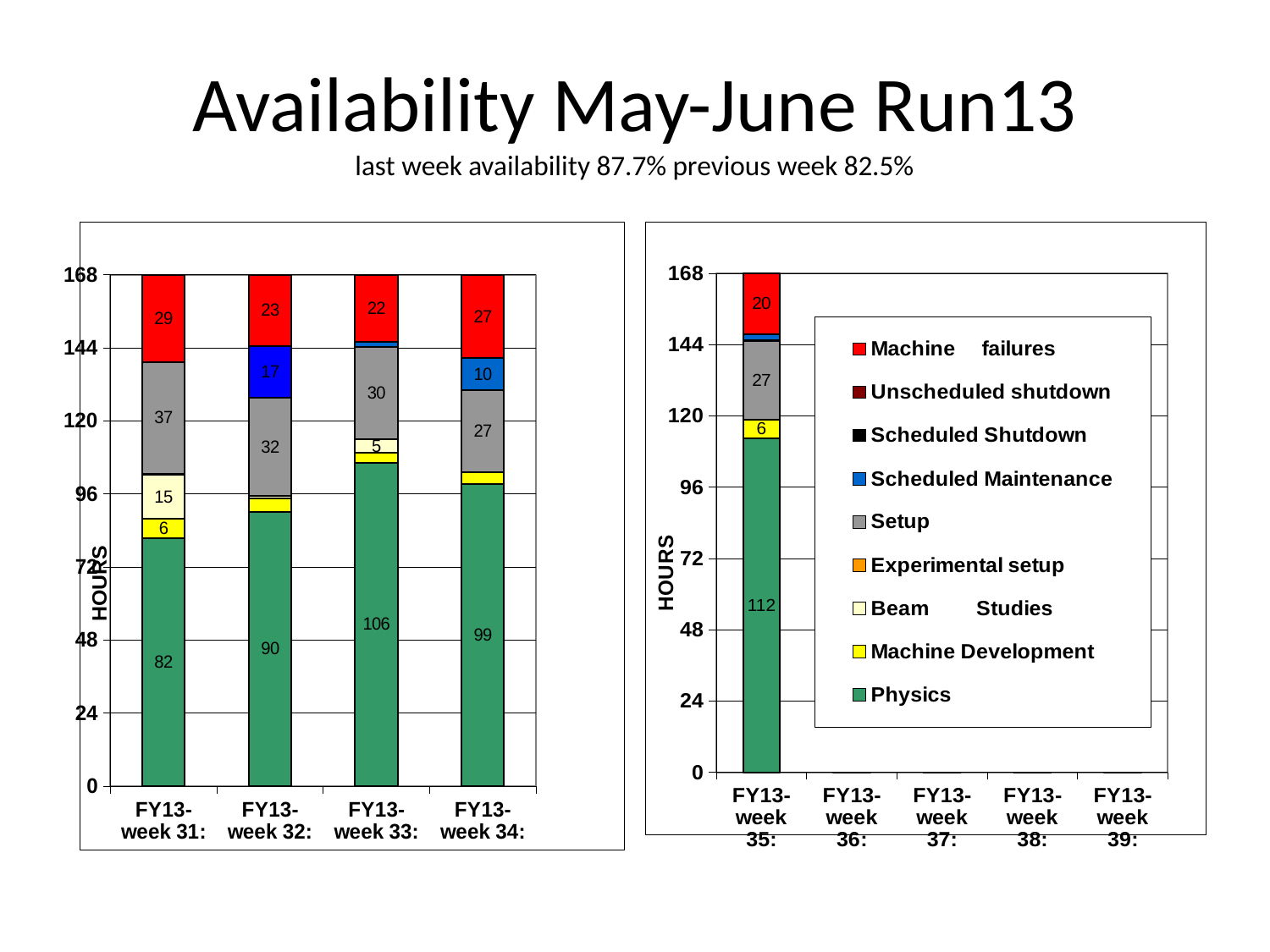
In the left chart, what is the Machine failures value for FY13-week 32? 23 In the right chart, what is the Setup value for FY13-week 35? 27 In the left chart, which week has the highest Physics value? FY13-week 33 How many series does the legend on the right chart list? 9 In the left chart, is the Physics value for FY13-week 32 greater or less than 72? greater In the left chart, what is the Physics value for FY13-week 31? 82 In the left chart, what is the difference between the Physics values for FY13-week 33 and FY13-week 31? 24 What kind of chart is the left chart? Stacked bar chart In the left chart, which week has the lowest Physics value? FY13-week 31 How many weeks are shown on the x axis of the left chart? 4 In the right chart, what is the Physics value for FY13-week 35? 112 In the left chart, which is larger: the Setup value for FY13-week 31 or for FY13-week 34? FY13-week 31